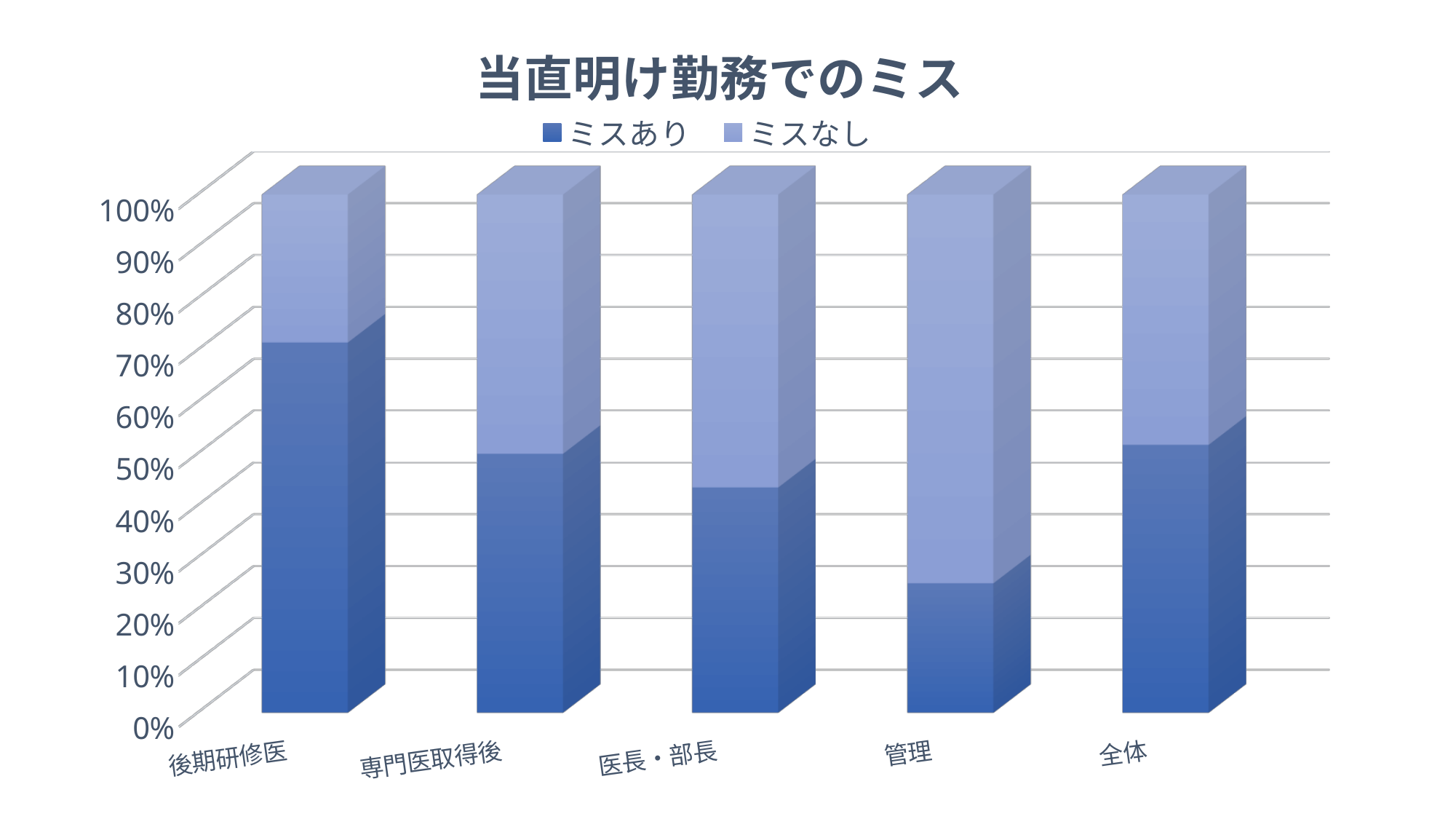
How many series does the legend list? 2 Is the ミスあり share for 管理 greater or less than 30%? less Which has a larger ミスなし share, 管理 or 医長・部長? 管理 What kind of chart is shown on the slide? Stacked bar chart Which category has the highest share of ミスあり? 後期研修医 How many categories are shown on the x axis? 5 Does the ミスあり share rise or fall from 後期研修医 to 管理? fall Which category has the lowest share of ミスあり? 管理 Is the ミスあり share for 医長・部長 greater or less than 50%? less Is the ミスあり share for 後期研修医 greater or less than 60%? greater Which has a larger ミスあり share, 後期研修医 or 管理? 後期研修医 What is the title of the chart? 当直明け勤務でのミス